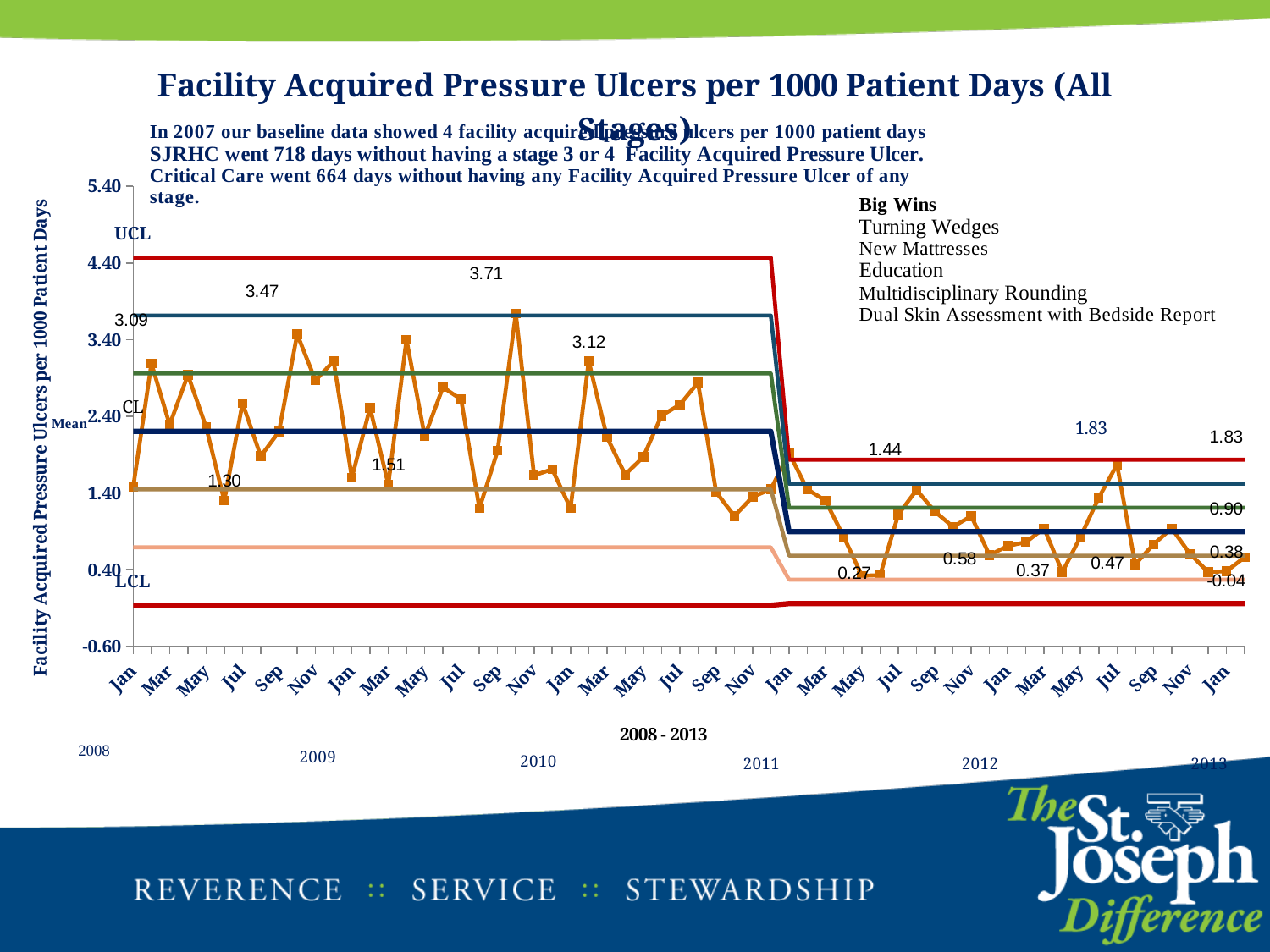
Overall, do the plotted values rise or fall along the x axis from 2008 to 2013? fall Are the plotted values in 2012 greater or less than 2.40? less Is the upper control limit (UCL) line during 2008 greater or less than 3.40? greater Which period has higher plotted values, 2009 or 2012? 2009 Is the highest plotted value on the chart greater or less than 3.40? greater What is the label on the vertical axis of the chart? Facility Acquired Pressure Ulcers per 1000 Patient Days What is the title of the chart? Facility Acquired Pressure Ulcers per 1000 Patient Days (All Stages) What kind of chart is shown on the slide? line chart